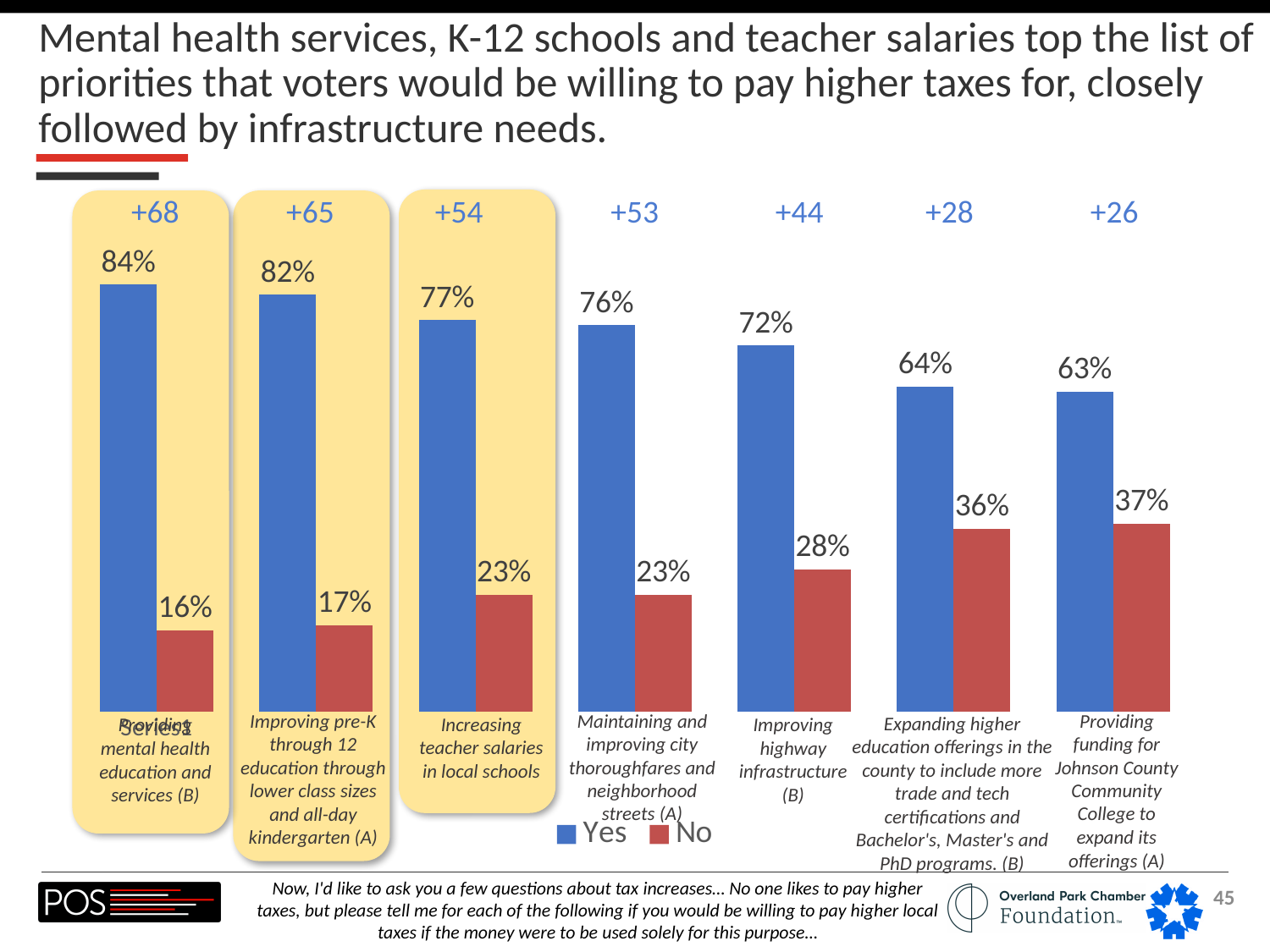
What is the No value for improving highway infrastructure? 28% What is the Yes value for expanding higher education offerings in the county? 64% How many series does the legend list? 2 Which is larger: the No value for maintaining and improving city thoroughfares and neighborhood streets, or the No value for improving highway infrastructure? Improving highway infrastructure How many categories are shown in the chart? 7 What kind of chart is shown on the slide? Bar chart Do the Yes values rise or fall moving from left to right across the categories? Fall Which category has the highest Yes value? Providing mental health education and services What percentage of voters said Yes to paying higher taxes for increasing teacher salaries in local schools? 77% What net figure is printed above the bars for increasing teacher salaries in local schools? +54 Which category has the lowest Yes value? Providing funding for Johnson County Community College to expand its offerings What is the difference between the Yes and No values for improving pre-K through 12 education? 65 percentage points